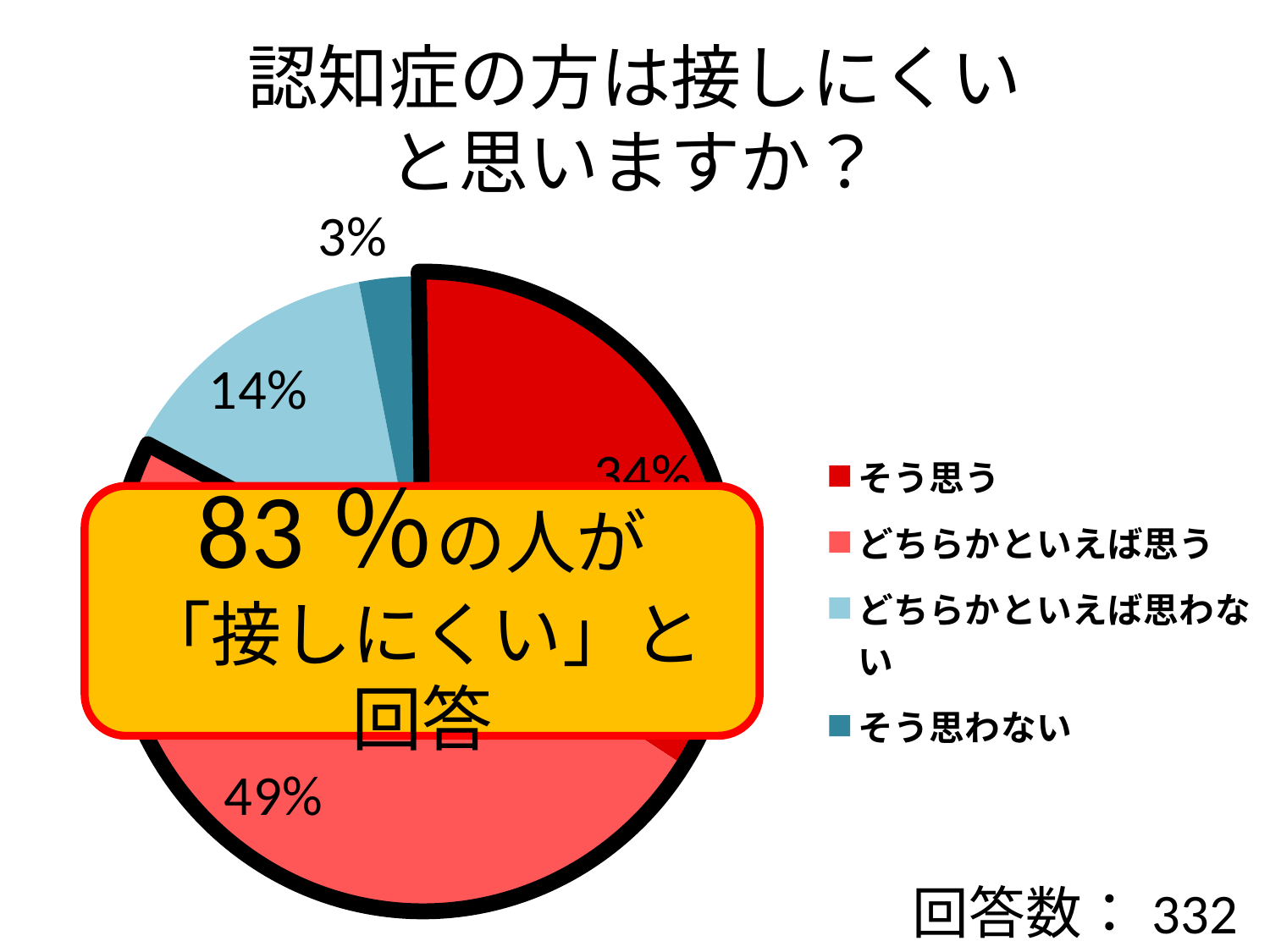
What percentage of respondents answered そう思わない? 3% What is the combined share of そう思う and どちらかといえば思う? 83% Which response category has the largest share of the pie? どちらかといえば思う Which is larger, the share for どちらかといえば思わない or the share for そう思わない? どちらかといえば思わない What kind of chart is shown on the slide? Pie chart What percentage of respondents answered そう思う? 34% Which response category has the smallest share of the pie? そう思わない What is the number of responses (回答数) shown on the slide? 332 How many categories does the legend list? 4 What is the difference in percentage points between どちらかといえば思う and どちらかといえば思わない? 35 What percentage of respondents answered どちらかといえば思う? 49% What percentage of respondents answered どちらかといえば思わない? 14%